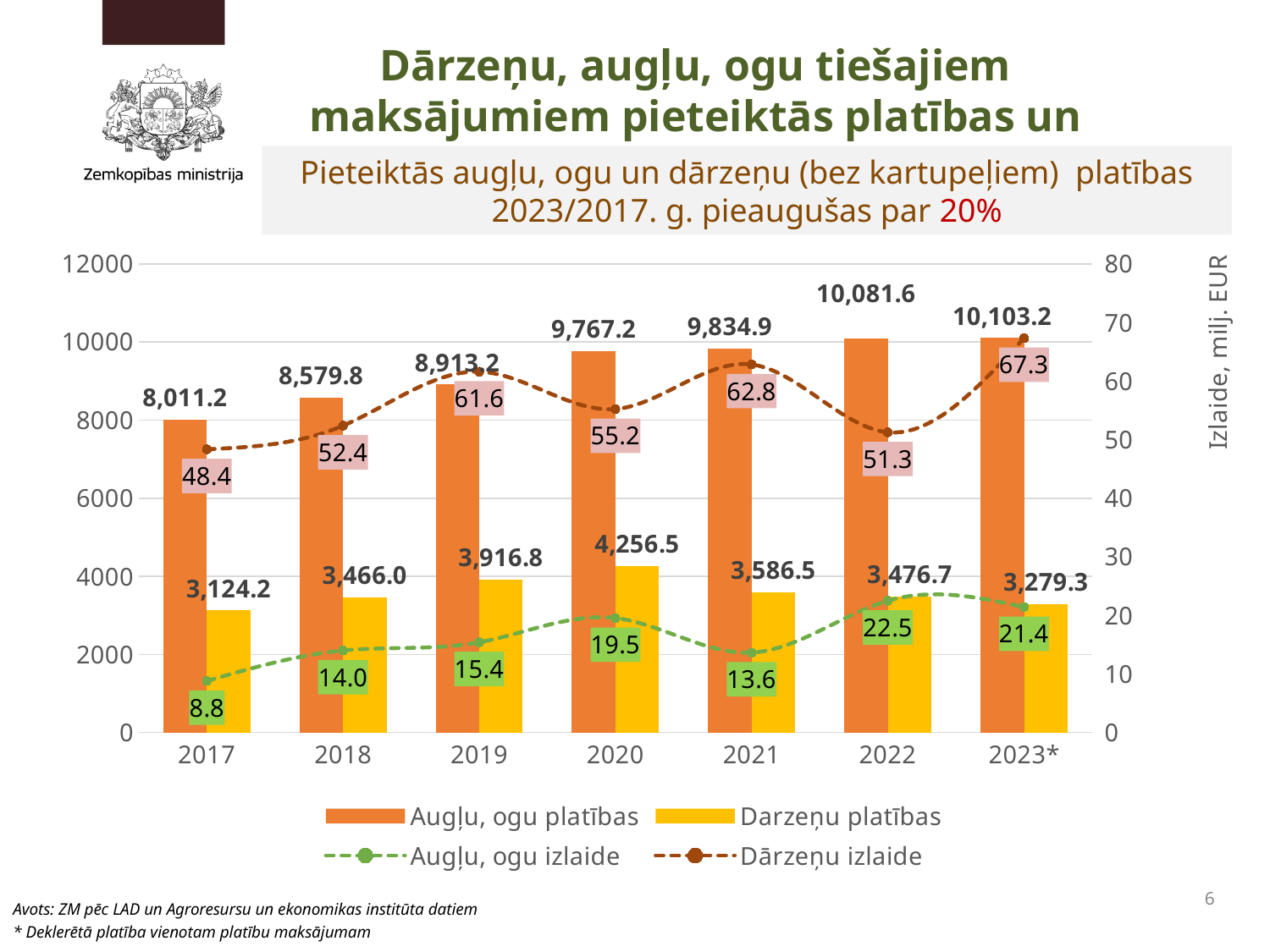
What is the value of Augļu, ogu izlaide for 2017? 8.8 In which year is Augļu, ogu izlaide lowest? 2017 What is the difference between Augļu, ogu platības in 2023* and in 2017? 2,092.0 Do the values of Augļu, ogu platības rise or fall from 2017 to 2023*? Rise Which is larger, Dārzeņu izlaide in 2019 or in 2020? 2019 What is the value of Dārzeņu izlaide for 2021? 62.8 How many series does the legend list? 4 What is the value of Augļu, ogu platības for 2020? 9,767.2 What is the value of Dārzeņu platības for 2019? 3,916.8 How many years are shown on the x axis? 7 What kind of chart is shown on the slide? Combined bar and line chart In which year is Dārzeņu platības highest? 2020